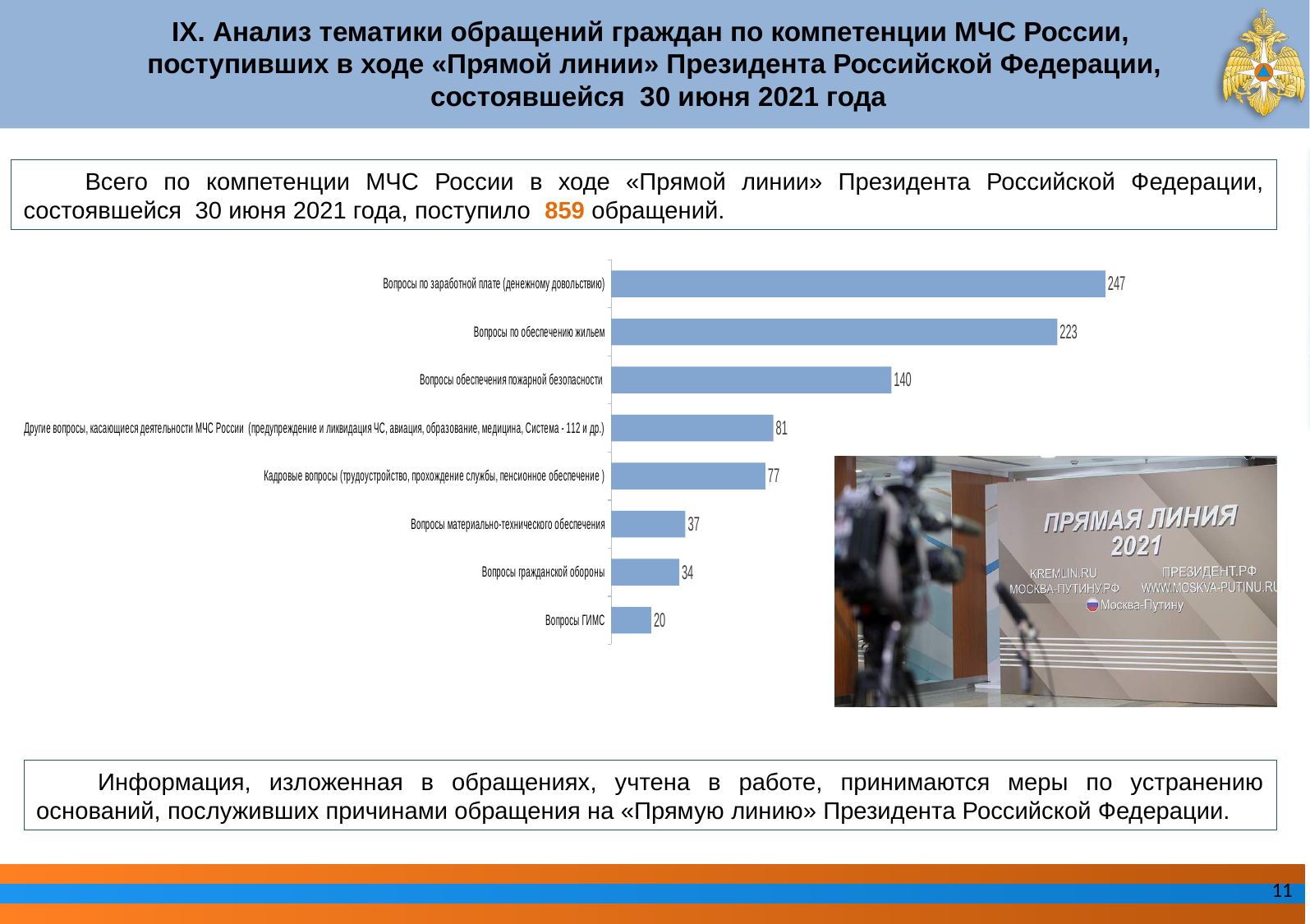
What is the value for «Вопросы ГИМС»? 20 How many categories does the bar chart show? 8 What is the difference between the values for «Вопросы по заработной плате (денежному довольствию)» and «Вопросы по обеспечению жильем»? 24 What kind of chart is shown on the slide? bar chart Which category has the highest value? Вопросы по заработной плате (денежному довольствию) What is the value for «Вопросы гражданской обороны»? 34 What is the value for «Вопросы по обеспечению жильем»? 223 Which category has the lowest value? Вопросы ГИМС What is the value for «Вопросы по заработной плате (денежному довольствию)»? 247 What is the value for «Вопросы обеспечения пожарной безопасности»? 140 What is the difference between the values for «Вопросы обеспечения пожарной безопасности» and «Вопросы ГИМС»? 120 Which is larger: the value for «Кадровые вопросы» or the value for «Вопросы материально-технического обеспечения»? Кадровые вопросы